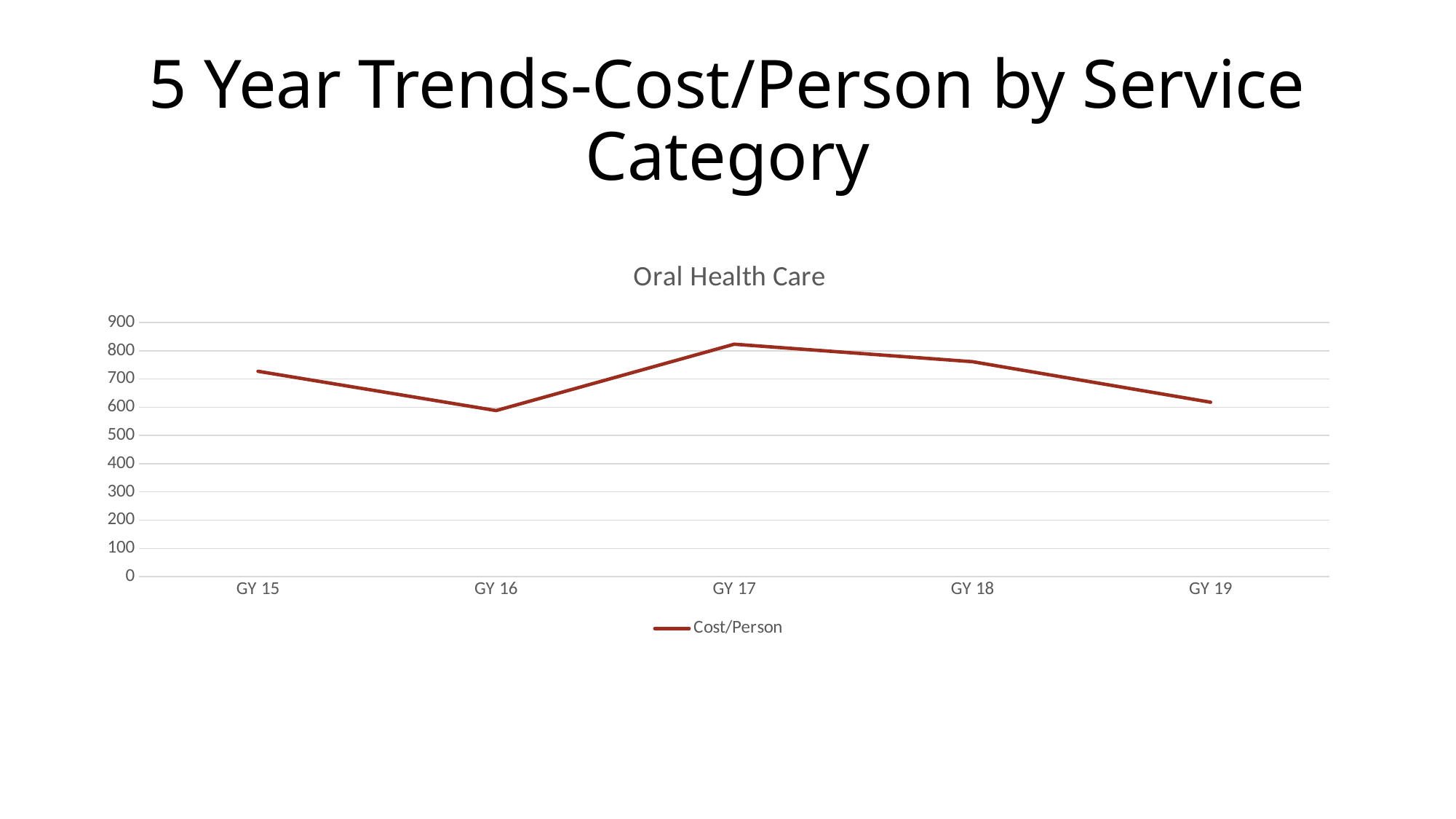
Which grant year has the highest Cost/Person? GY 17 Is the Cost/Person for GY 17 greater or less than 800? greater How many grant years are plotted on the x axis? 5 Is the Cost/Person for GY 16 greater or less than 700? less Is the Cost/Person for GY 15 greater or less than 700? greater Does the Cost/Person rise or fall from GY 17 to GY 19? fall Which is larger, the Cost/Person for GY 15 or for GY 19? GY 15 Which grant year has the lowest Cost/Person? GY 16 How many series does the legend list? 1 What kind of chart is shown on the slide? line chart What is the title of the chart? Oral Health Care What is the name of the series shown in the legend? Cost/Person